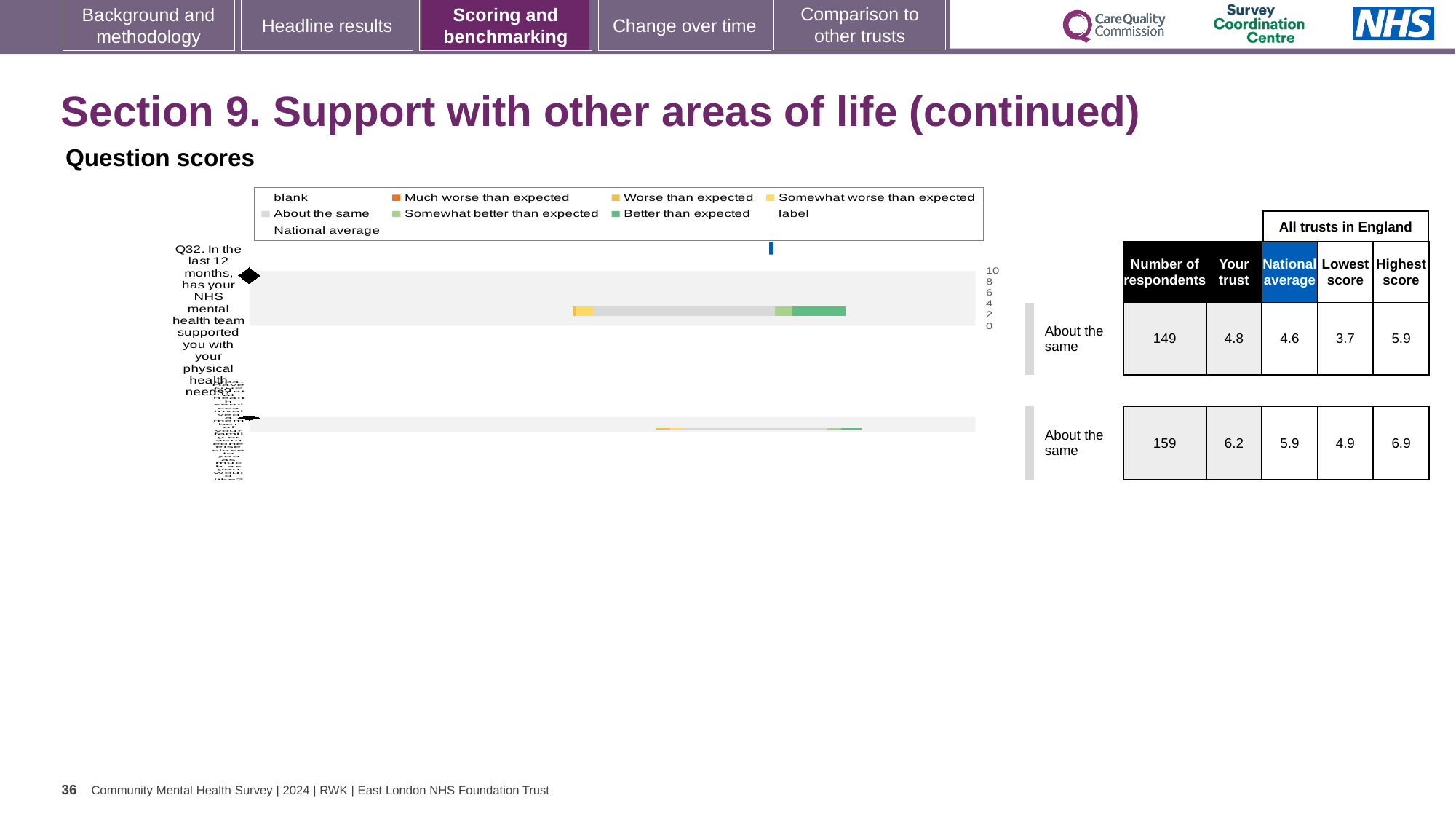
How many question bars are plotted in the chart? 2 How many respondents answered Q32? 149 What is the national average score for Q32? 4.6 What is the highest score among all trusts in England for Q32? 5.9 What kind of chart is shown on the slide? Bar chart For Q32, what is the difference between the 'Your trust' score and the national average? 0.2 What is the 'Your trust' score for Q32 (support with physical health needs)? 4.8 What is the lowest score among all trusts in England for Q32? 3.7 For Q32, which is larger: the 'Your trust' score or the national average? Your trust What is the 'Your trust' score for the second (lower) question bar? 6.2 What benchmark category is shown for Q32? About the same For the second (lower) question bar, what is the difference between the highest and lowest scores among all trusts in England? 2.0